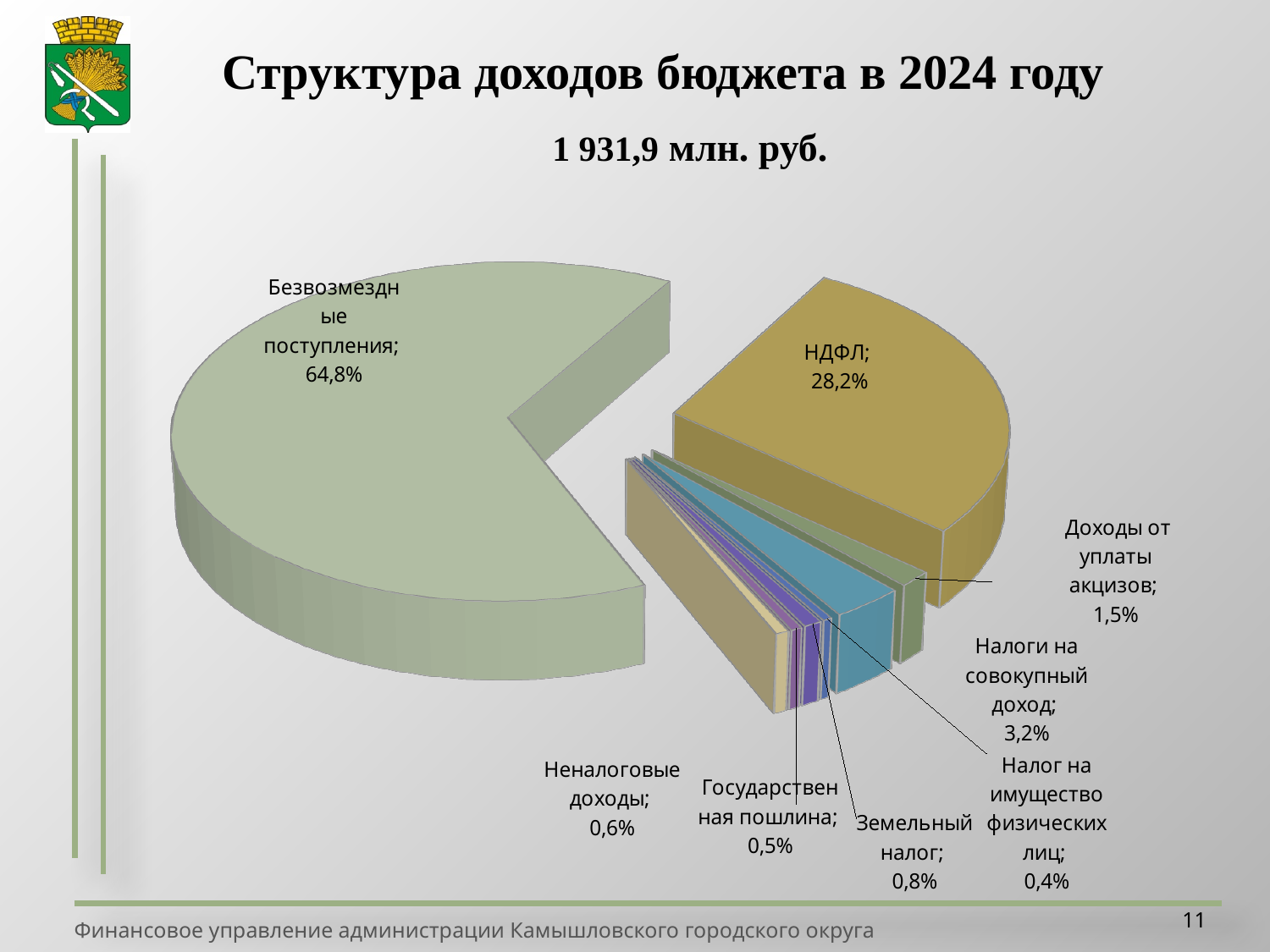
What share of budget revenue comes from Безвозмездные поступления? 64,8% What is the difference in percentage points between Безвозмездные поступления and НДФЛ? 36,6 What share is shown for Налоги на совокупный доход? 3,2% What share is shown for Земельный налог? 0,8% How many slices does the pie chart have? 8 Which revenue source has the largest share of the budget? Безвозмездные поступления What share is shown for Доходы от уплаты акцизов? 1,5% What is the share of НДФЛ in the budget revenue structure? 28,2% What type of chart is shown on the slide? pie chart What total budget revenue amount is stated under the chart title? 1 931,9 млн. руб. Which is larger: the share of Неналоговые доходы or the share of Государственная пошлина? Неналоговые доходы Which revenue source has the smallest share of the budget? Налог на имущество физических лиц